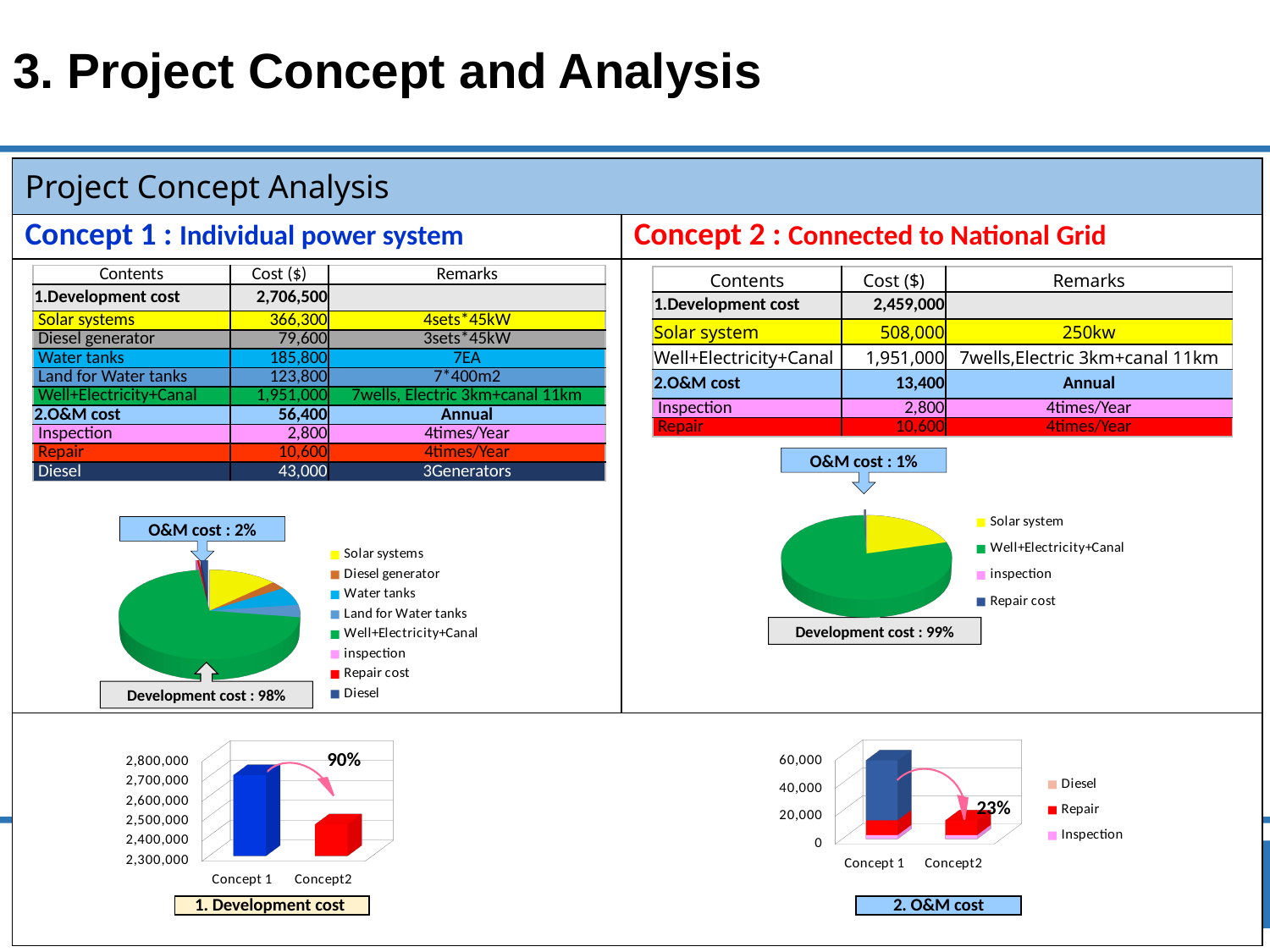
In the '1. Development cost' chart, is the value for Concept 1 greater or less than 2,600,000? greater How many categories are shown on the x axis of the '1. Development cost' chart? 2 In the '2. O&M cost' chart, is the total for Concept 1 greater or less than 40,000? greater In the '2. O&M cost' chart, is the total for Concept2 greater or less than 20,000? less In the '1. Development cost' chart, which concept has the higher bar? Concept 1 In the Concept 2 pie chart, how many entries does the legend list? 4 In the Concept 1 pie chart, which category has the largest slice? Well+Electricity+Canal In the Concept 1 pie chart, how many entries does the legend list? 8 In the '2. O&M cost' chart, how many series does the legend list? 3 What kind of chart is the '1. Development cost' chart at the bottom left? bar chart In the Concept 2 pie chart, which category has the largest slice? Well+Electricity+Canal